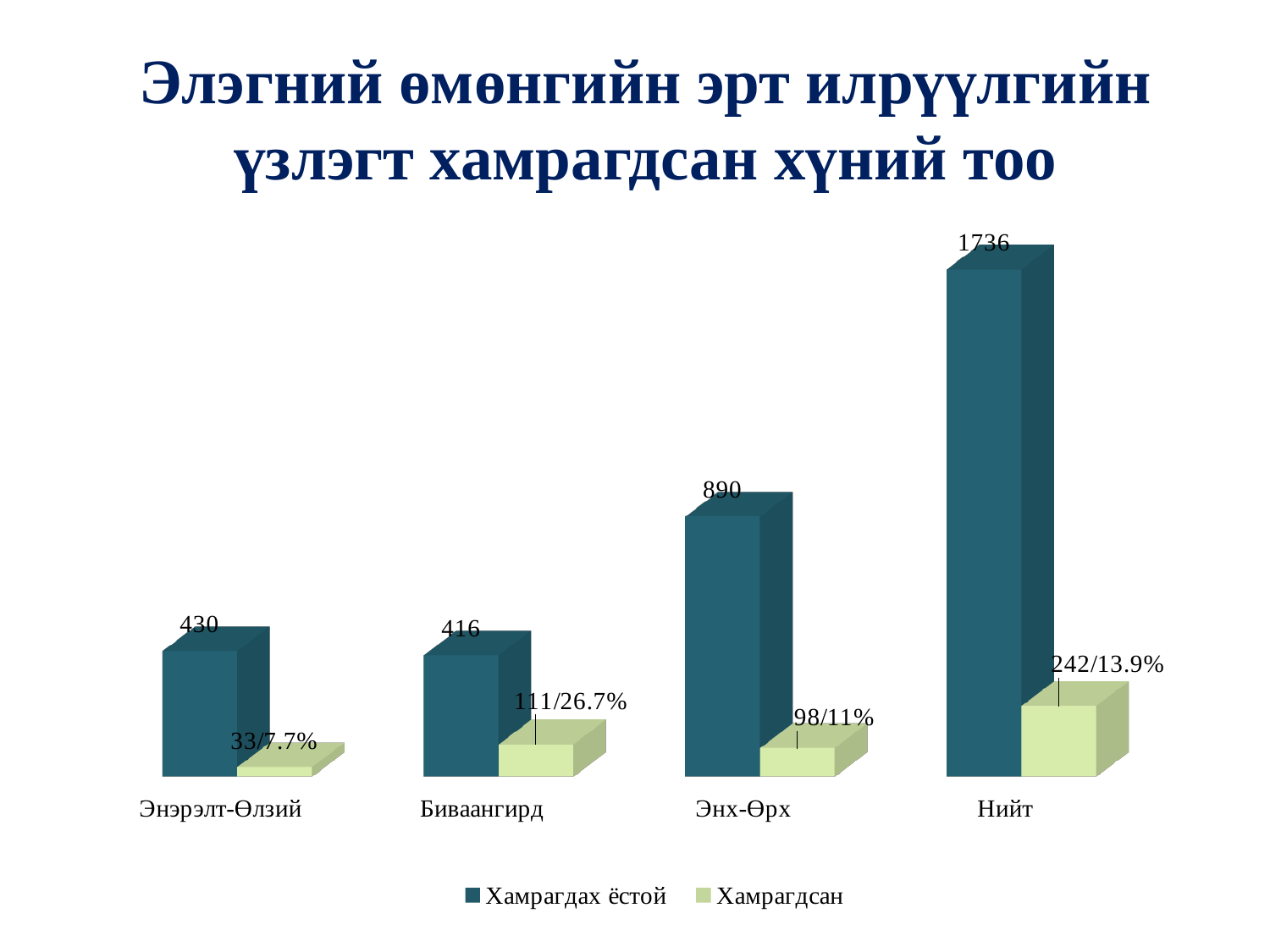
What data label is shown for Хамрагдсан at Биваангирд? 111/26.7% How many categories are shown on the x axis? 4 Which is larger, the Хамрагдах ёстой value for Энэрэлт-Өлзий or for Биваангирд? Энэрэлт-Өлзий What is the value of Хамрагдах ёстой for Нийт? 1736 What is the value of Хамрагдах ёстой for Энх-Өрх? 890 What is the difference between the Хамрагдах ёстой values for Энх-Өрх and Биваангирд? 474 Which series is shown in light green in the legend? Хамрагдсан What kind of chart is shown on the slide? Bar chart How many series does the legend list? 2 Which category has the lowest Хамрагдах ёстой value? Биваангирд Which category has the highest Хамрагдах ёстой value? Нийт What data label is shown for Хамрагдсан at Энэрэлт-Өлзий? 33/7.7%